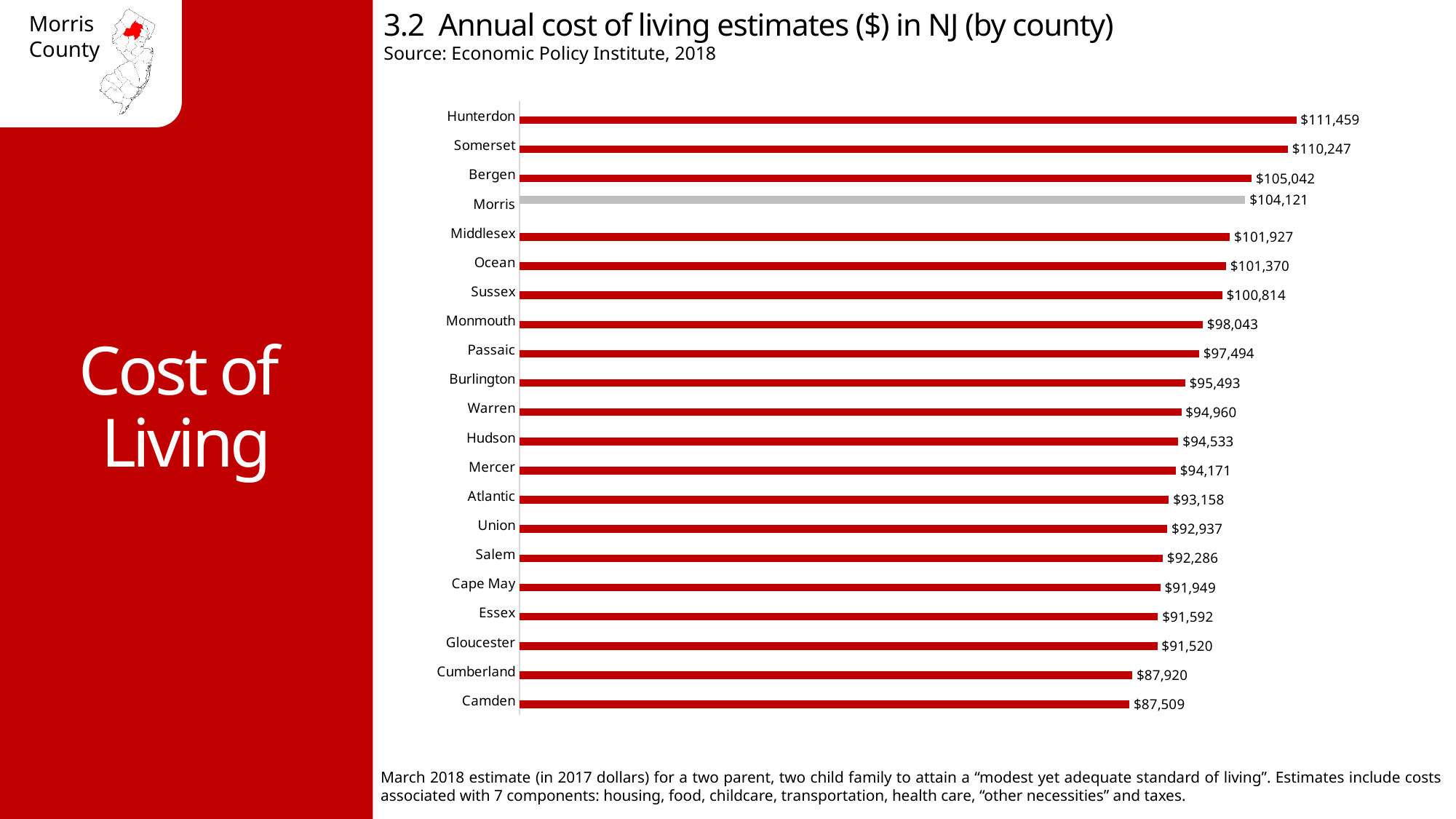
Do the cost of living values increase or decrease going from the top of the chart to the bottom? Decrease What is the annual cost of living estimate for Morris County? $104,121 Which county has the highest annual cost of living estimate? Hunterdon Which county's bar is coloured grey instead of red? Morris What is the annual cost of living estimate for Cumberland County? $87,920 What is the annual cost of living estimate for Hudson County? $94,533 How many counties are shown in the chart? 21 Which county has the lowest annual cost of living estimate? Camden What is the difference between the cost of living estimates for Bergen and Morris? $921 What is the difference between the cost of living estimates for Hunterdon and Camden? $23,950 Which county has a higher cost of living estimate, Ocean or Monmouth? Ocean What kind of chart is shown on the slide? Bar chart